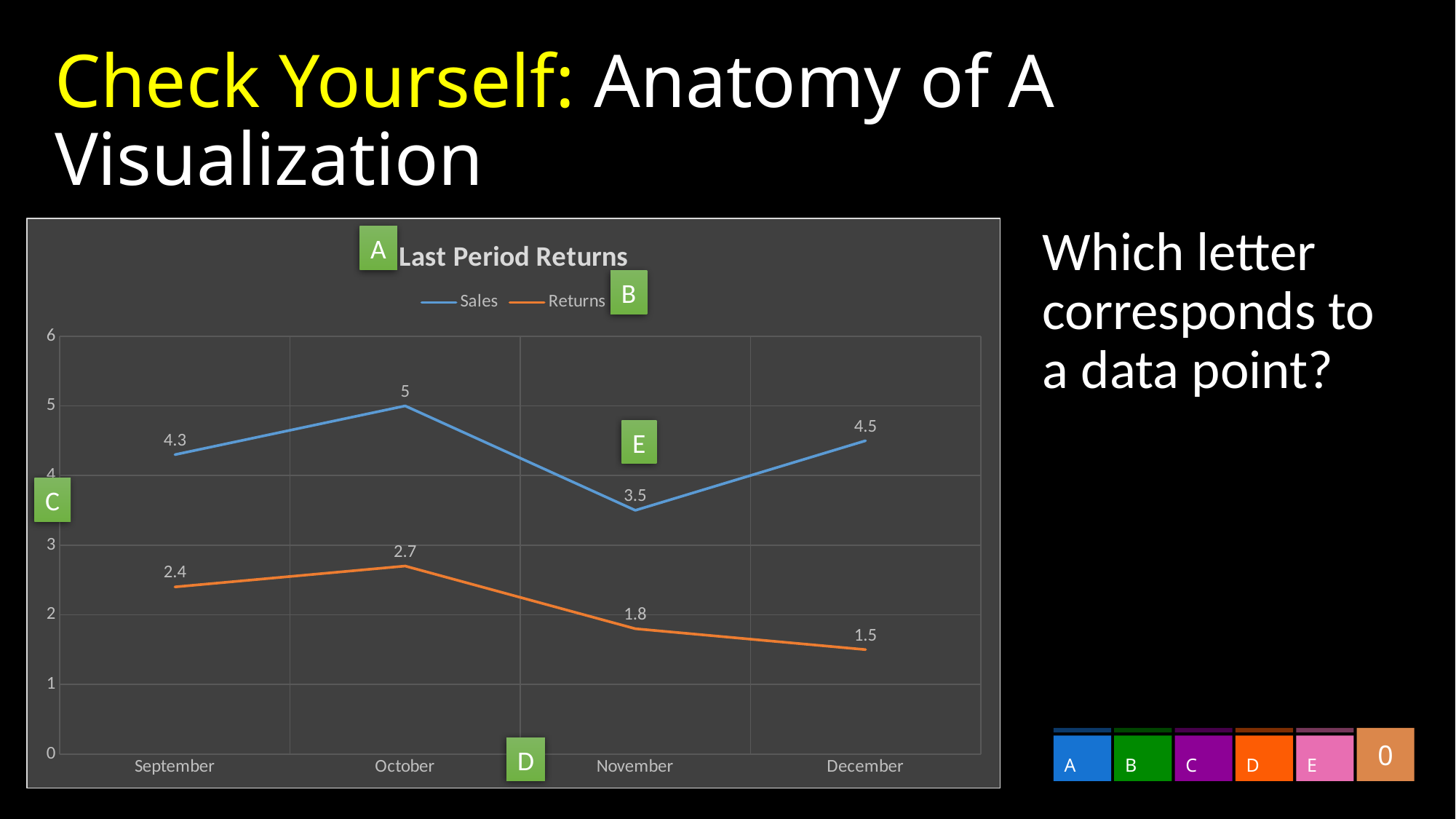
What kind of chart is shown? line chart How many series does the legend list? 2 Which is larger, the Sales value in November or the Sales value in December? December Which month has the highest Sales value? October What is the Sales value for December? 4.5 Which month has the lowest Returns value? December What is the Sales value for October? 5 What is the title of the chart? Last Period Returns Is the Returns value for October greater or less than 3? less How many months are shown on the x axis? 4 What is the difference between the Sales value and the Returns value in September? 1.9 What is the Returns value for November? 1.8